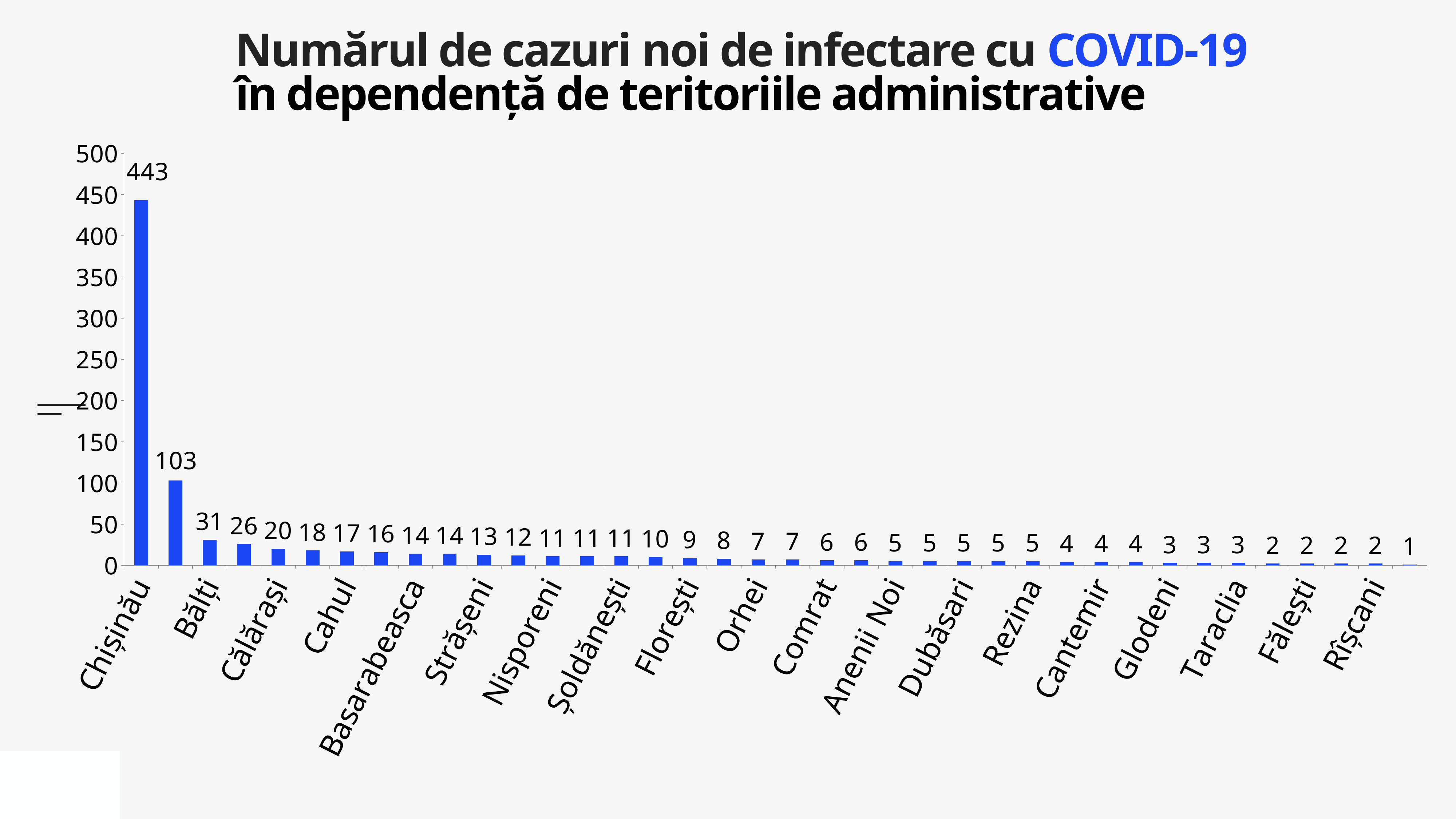
What is the value of the tallest bar in the chart? 443 What is the highest value shown on the vertical axis? 500 How many bars are plotted in the chart? 38 What colour are the bars in the chart? blue What type of chart is shown on the slide? bar chart Do the bar values rise or fall from left to right along the x axis? fall Is the value for Chișinău greater or less than 400? greater What is the difference between the two tallest bars (443 and 103)? 340 What is the value of the smallest bar in the chart? 1 What is the value of the second tallest bar? 103 Which territory has the highest number of new COVID-19 cases? Chișinău What is the number of new cases for Chișinău? 443